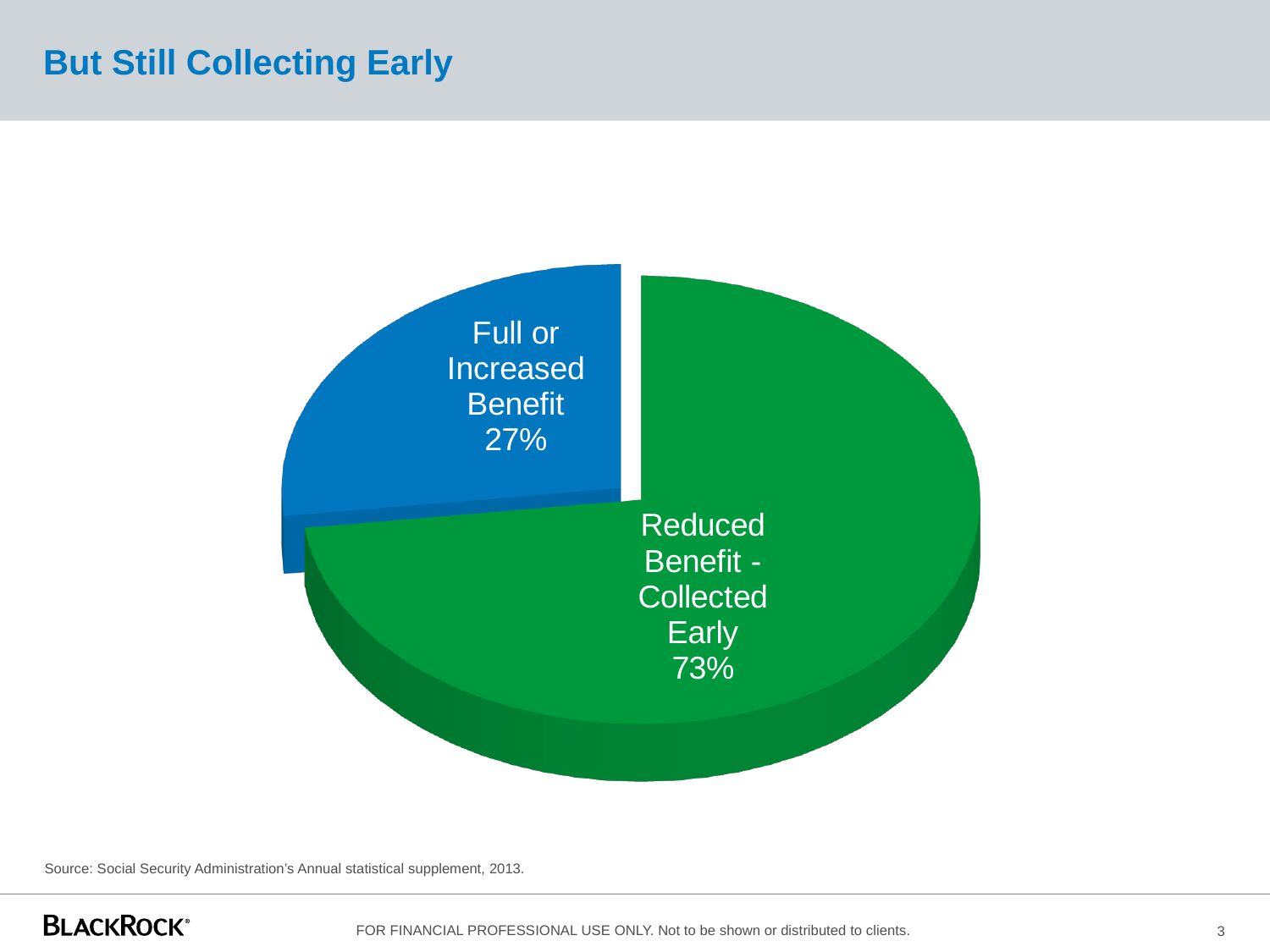
Which is larger: the "Full or Increased Benefit" slice or the "Reduced Benefit - Collected Early" slice? Reduced Benefit - Collected Early What colour is the "Reduced Benefit - Collected Early" slice? Green What is the difference in percentage points between the "Reduced Benefit - Collected Early" slice and the "Full or Increased Benefit" slice? 46 What is the title of the slide containing the pie chart? But Still Collecting Early How many slices does the pie chart have? 2 What share of the pie does the "Full or Increased Benefit" slice represent? 27% What percentage of the pie is labelled "Full or Increased Benefit"? 27% Which slice of the pie is the smallest? Full or Increased Benefit What type of chart is shown on the slide? Pie chart Which slice of the pie is the largest? Reduced Benefit - Collected Early What percentage of the pie is labelled "Reduced Benefit - Collected Early"? 73%